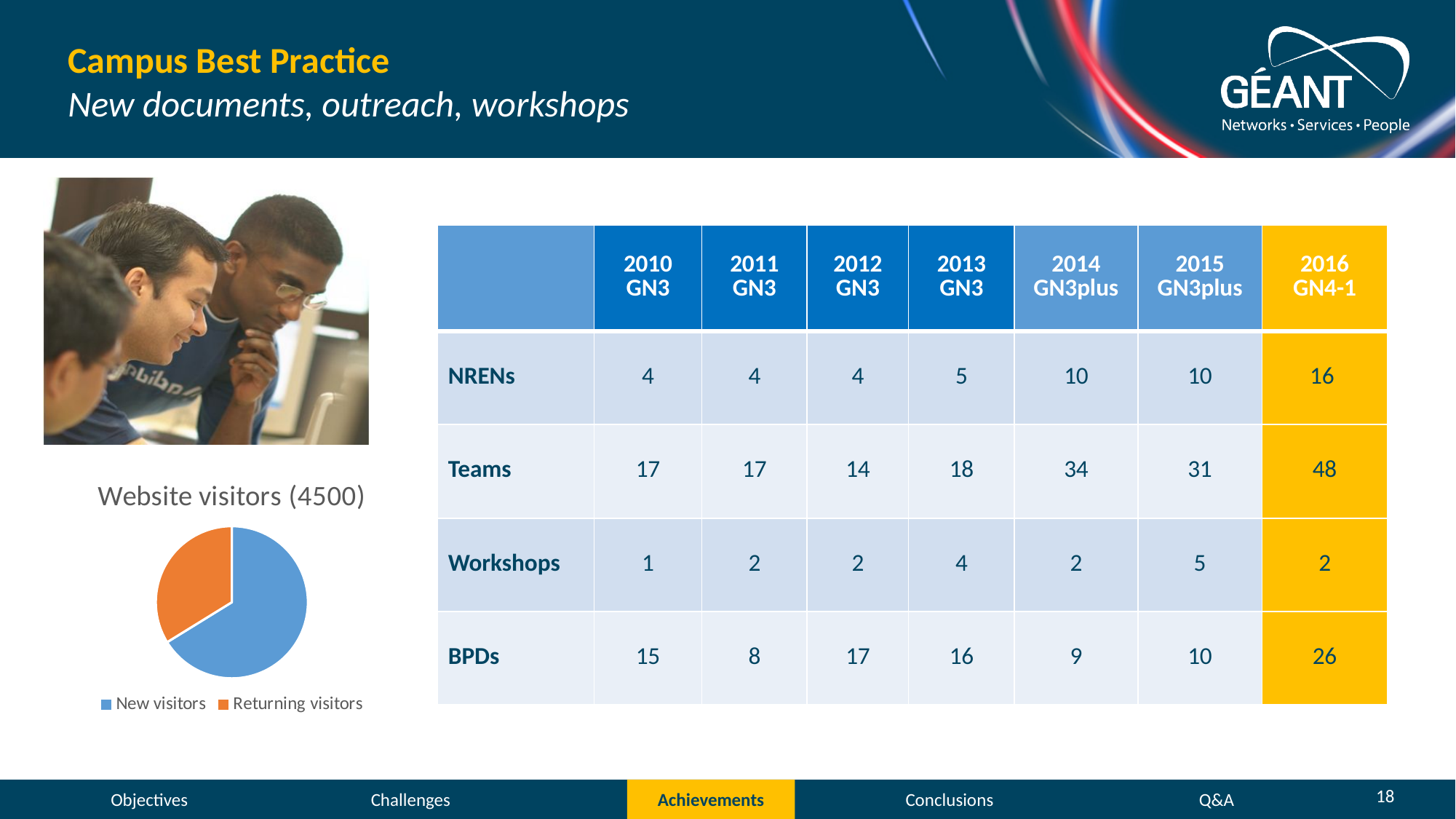
How many entries does the legend of the pie chart list? 2 What is the title of the pie chart on the slide? Website visitors (4500) What colour is the Returning visitors slice in the pie chart? orange How many slices does the pie chart have? 2 What kind of chart is shown under the heading "Website visitors (4500)"? pie chart Which slice of the pie chart is the largest? New visitors In the pie chart, which is larger: New visitors or Returning visitors? New visitors Which slice of the pie chart is the smallest? Returning visitors